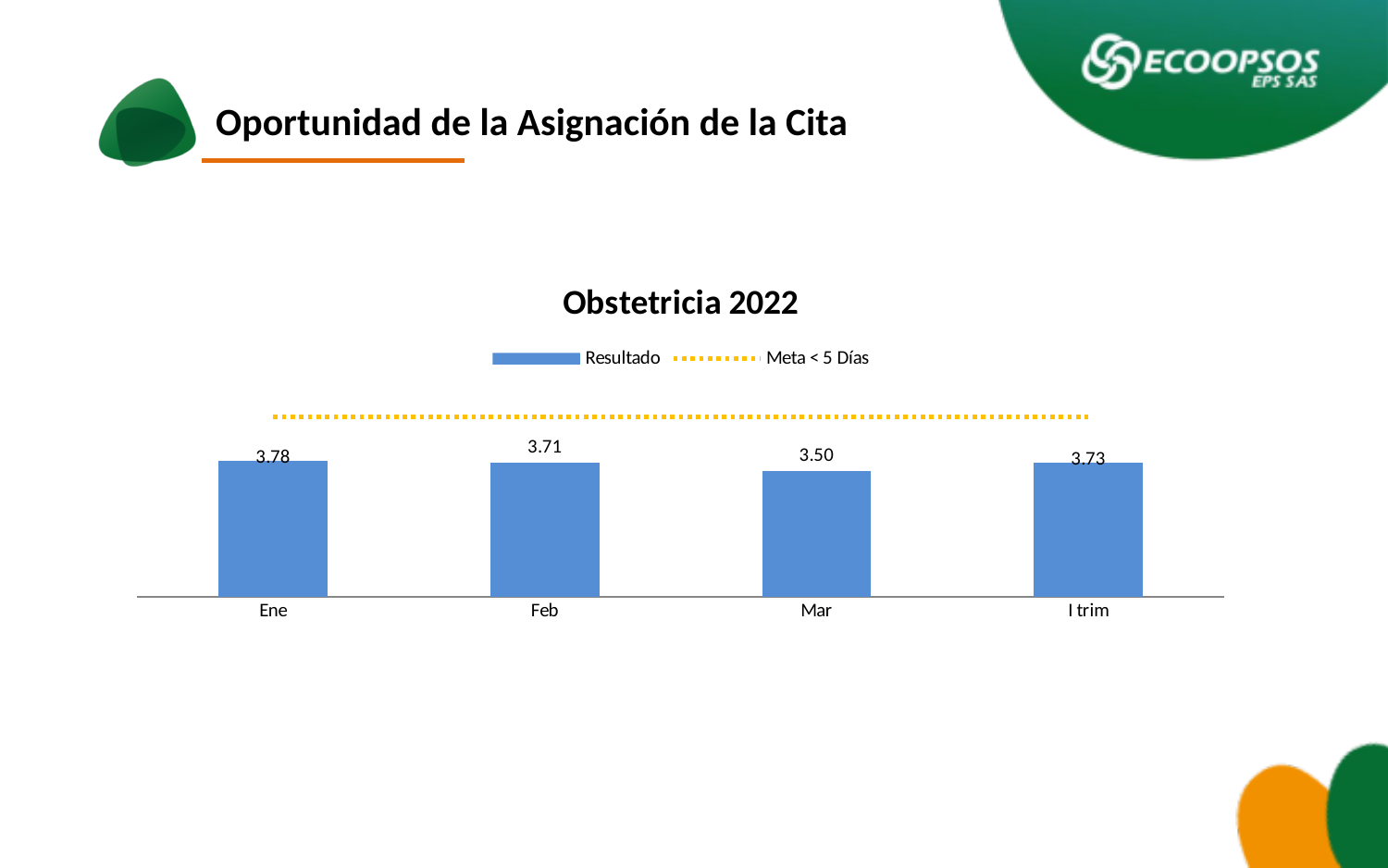
How many categories are shown on the x axis? 4 What is the title of the chart? Obstetricia 2022 How many series does the legend list? 2 What is the difference between the Resultado values for Ene and Mar? 0.28 What is the Resultado value for Mar? 3.50 Which is larger, the Resultado value for Feb or for I trim? I trim Which category has the lowest Resultado value? Mar What kind of chart is used to show the Resultado values? Bar chart What is the Resultado value for Ene? 3.78 What is the Resultado value for I trim? 3.73 What is the Resultado value for Feb? 3.71 Which category has the highest Resultado value? Ene